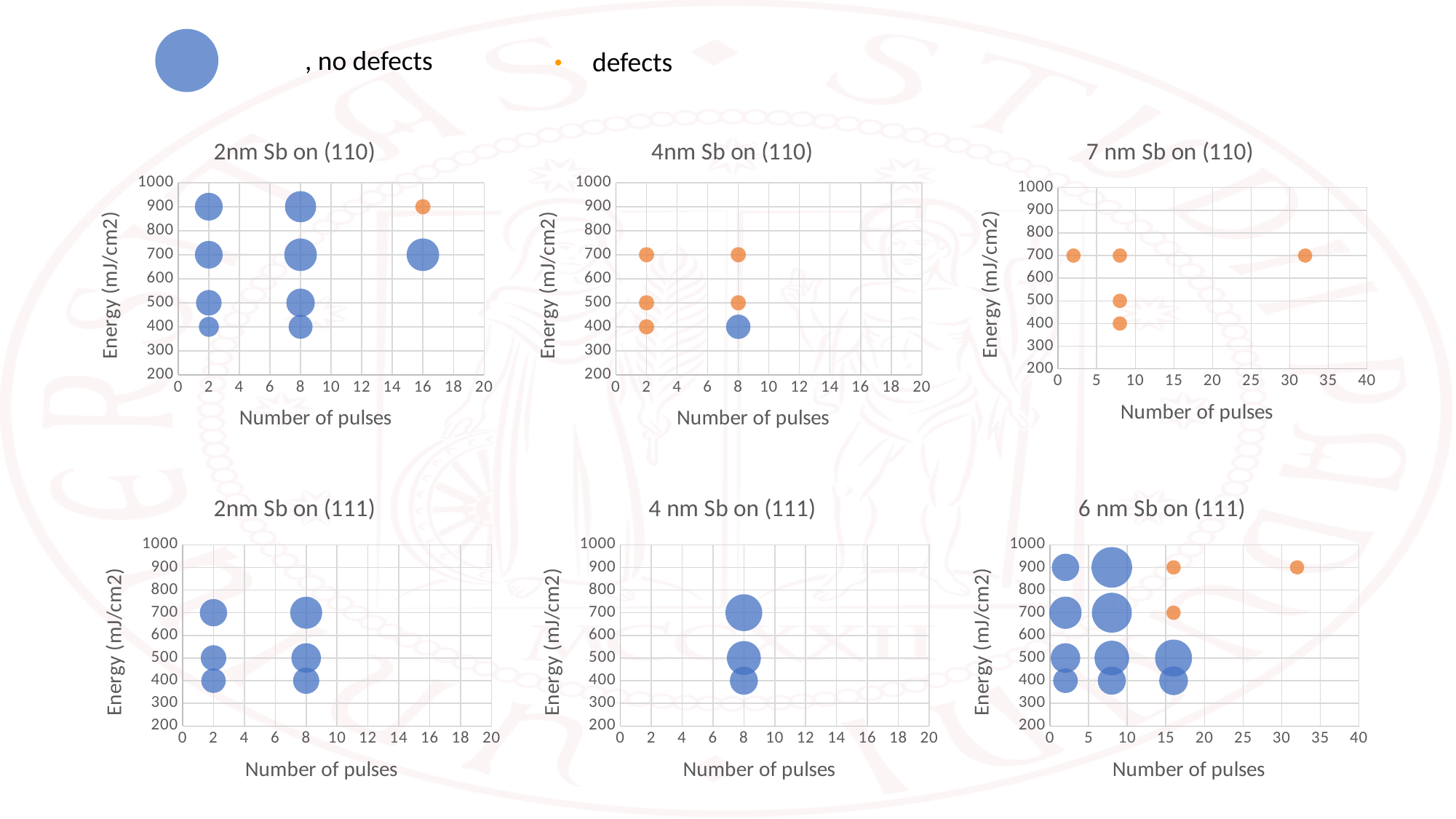
According to the legend, which colour marks "defects"? orange In the "2nm Sb on (110)" chart, at what energy is the orange (defects) point plotted? 900 In the "4 nm Sb on (111)" chart, at what number of pulses are all the points plotted? 8 In the "4nm Sb on (110)" chart, what is the lowest energy at which a point is plotted? 400 In the "7 nm Sb on (110)" chart, how many points are plotted? 5 In the "2nm Sb on (110)" chart, what is the highest energy at which a point is plotted? 900 In the "2nm Sb on (111)" chart, how many points are plotted? 6 In the "6 nm Sb on (111)" chart, how many orange (defects) points are plotted? 3 In the "7 nm Sb on (110)" chart, at what energy is the point plotted at 32 pulses? 700 What kind of chart is "2nm Sb on (110)"? bubble chart